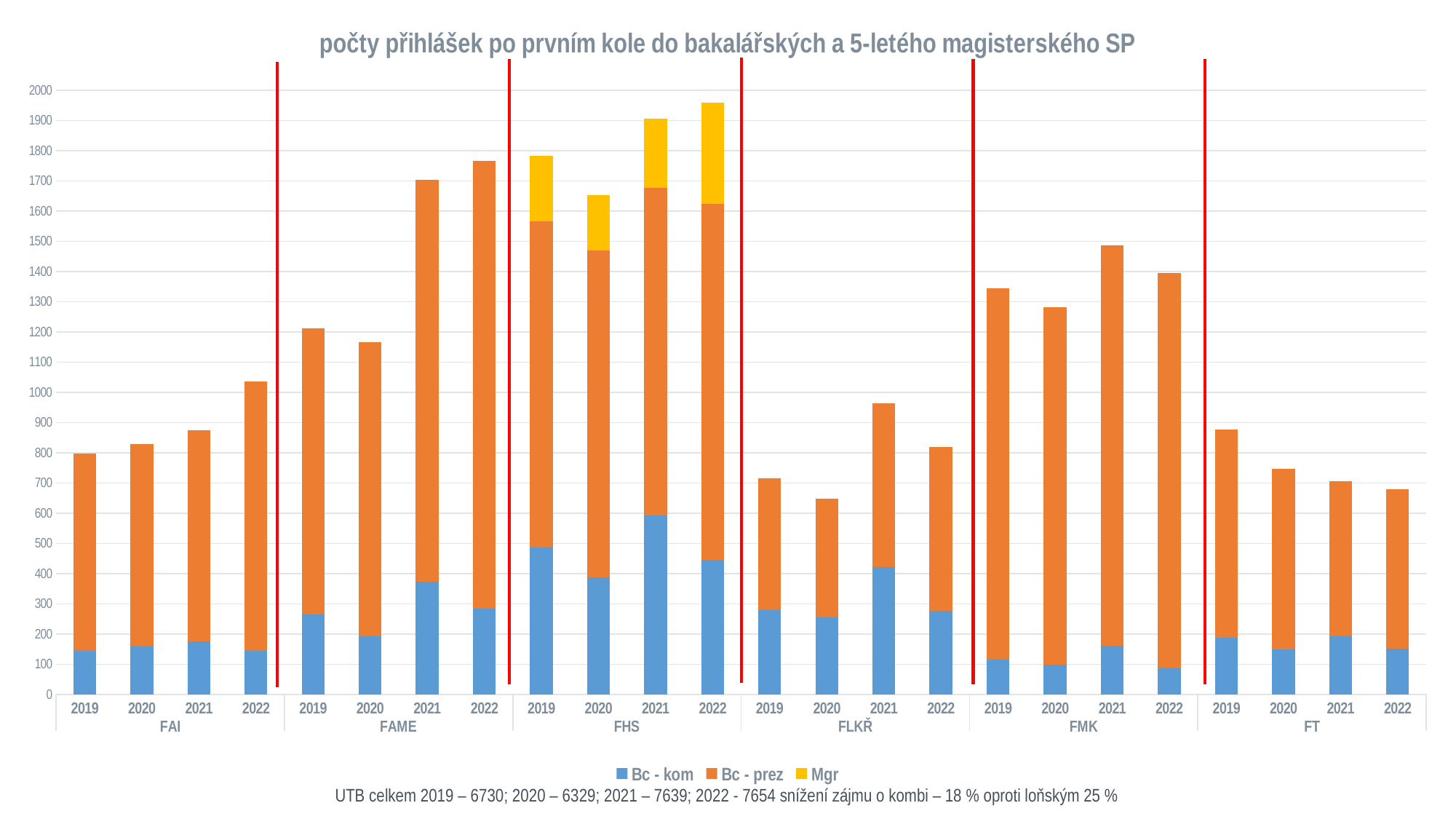
What kind of chart is shown on the slide? stacked bar chart Which faculty and year has the shortest bar? FLKŘ 2020 Do the totals for FAI rise or fall from 2019 to 2022? rise Is the total for FAI 2022 greater or less than 1000? greater Is the Bc - kom value for FHS 2021 greater or less than 500? greater Is the total for FMK 2021 greater or less than 1400? greater How many series does the legend list? 3 Which is larger, the total for FAME 2019 or FAME 2020? FAME 2019 Which faculty and year has the tallest bar? FHS 2022 Which faculty is the only one with a Mgr segment in its bars? FHS How many bars are plotted in the chart? 24